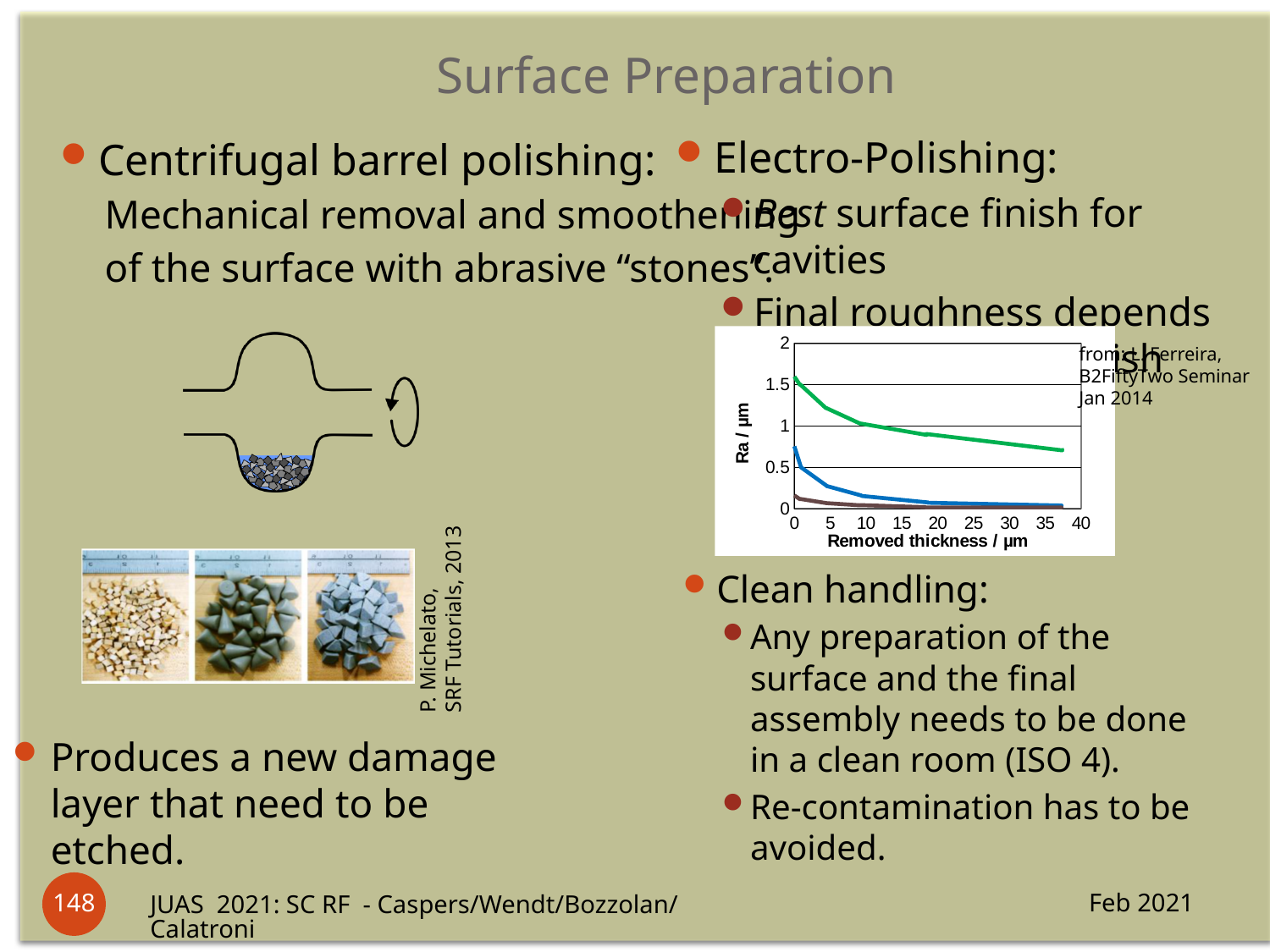
What kind of chart is shown on the slide? line chart Is the Ra value of the green line at a removed thickness of 30 µm greater or less than 1? less What is the label of the x axis of the chart? Removed thickness / µm How many lines are plotted on the chart? 3 Is the Ra value of the green line at a removed thickness of 0 µm greater or less than 1? greater Which line is higher at a removed thickness of 20 µm, the green line or the blue line? the green line Is the Ra value of the blue line at a removed thickness of 0 µm greater or less than 1? less Which line has the highest Ra value at a removed thickness of 0 µm? the green line What is the label of the y axis of the chart? Ra / µm Do the plotted values rise or fall as removed thickness increases? fall Which line has the lowest Ra value at a removed thickness of 0 µm? the brown line